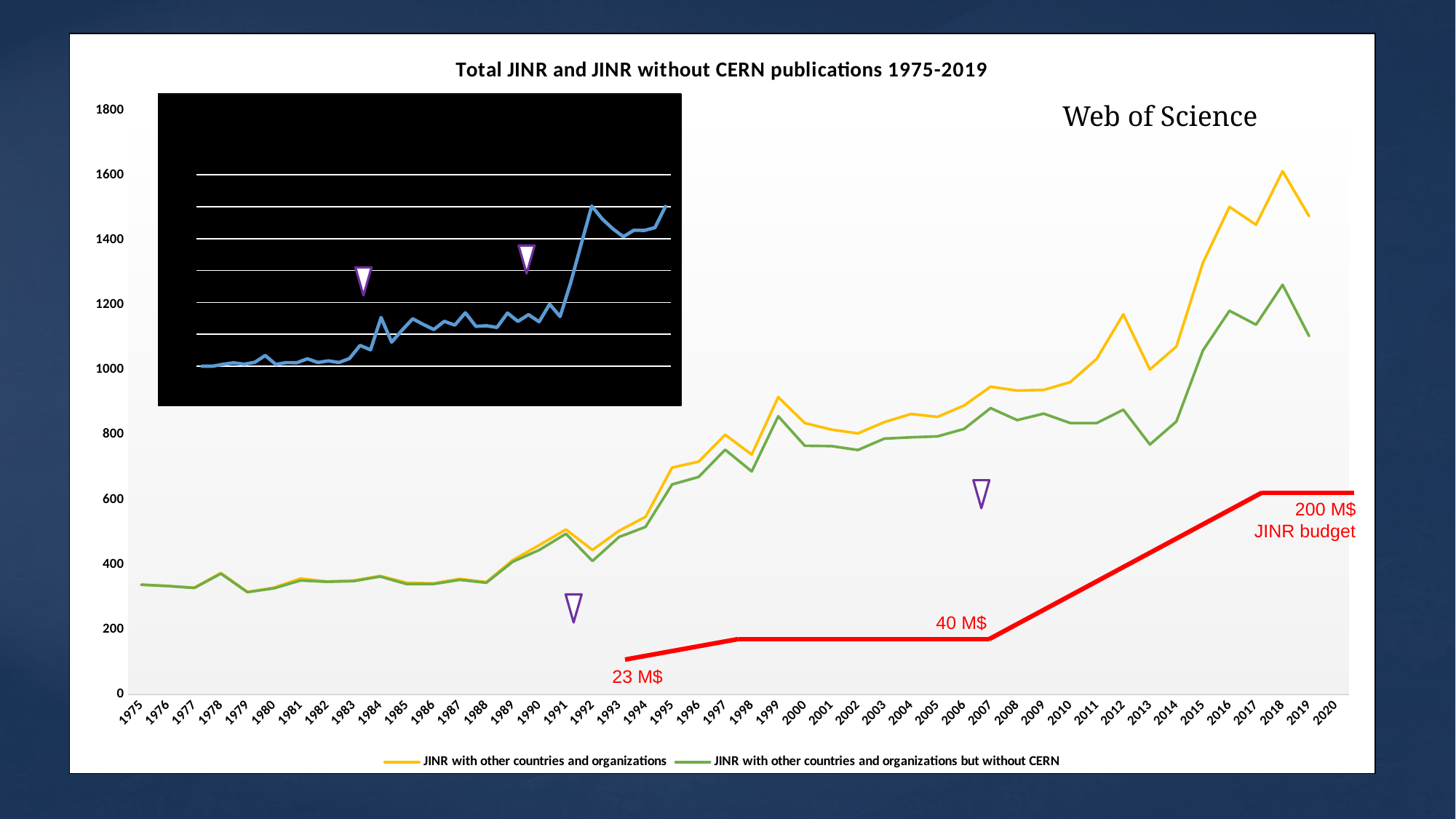
How many series does the chart legend list? 2 What JINR budget value is labelled at the right end of the red line? 200 M$ Is the value for 'JINR with other countries and organizations' in 2018 greater or less than 1400? greater In 2018, which series has the larger value: 'JINR with other countries and organizations' or 'JINR with other countries and organizations but without CERN'? JINR with other countries and organizations What is the title of the chart? Total JINR and JINR without CERN publications 1975-2019 Is the value for 'JINR with other countries and organizations' in 2012 greater or less than 1000? greater Which colour is used for the series 'JINR with other countries and organizations'? yellow In which year does the 'JINR with other countries and organizations' series reach its highest value? 2018 Does the 'JINR with other countries and organizations' series generally rise or fall from 1975 to 2018? rise What type of chart is shown on the slide? line chart Is the value for 'JINR with other countries and organizations but without CERN' in 2018 greater or less than 1000? greater